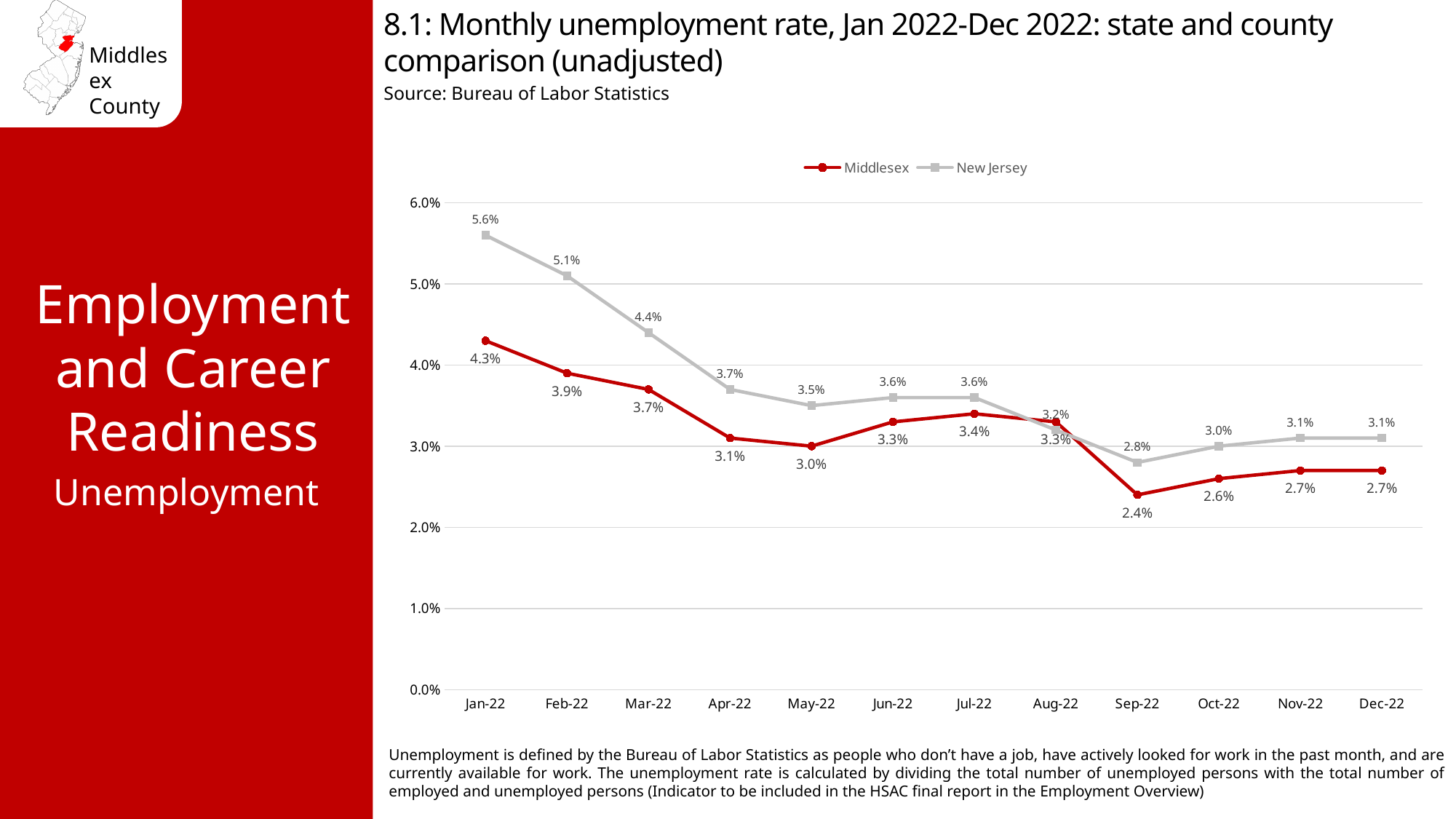
What was the Middlesex unemployment rate in Sep-22? 2.4% How many months are plotted on the x axis? 12 What kind of chart is shown on the slide? line chart In which month was the Middlesex unemployment rate lowest? Sep-22 Does the New Jersey unemployment rate rise or fall from Jan-22 to Apr-22? fall What was the New Jersey unemployment rate in Mar-22? 4.4% What is the difference between the New Jersey and Middlesex unemployment rates in Jan-22? 1.3% Is the New Jersey unemployment rate in Feb-22 greater or less than 5.0%? greater In which month was the New Jersey unemployment rate highest? Jan-22 What was the Middlesex unemployment rate in Jan-22? 4.3% How many series does the legend list? 2 Which was higher in Aug-22, the Middlesex rate or the New Jersey rate? Middlesex